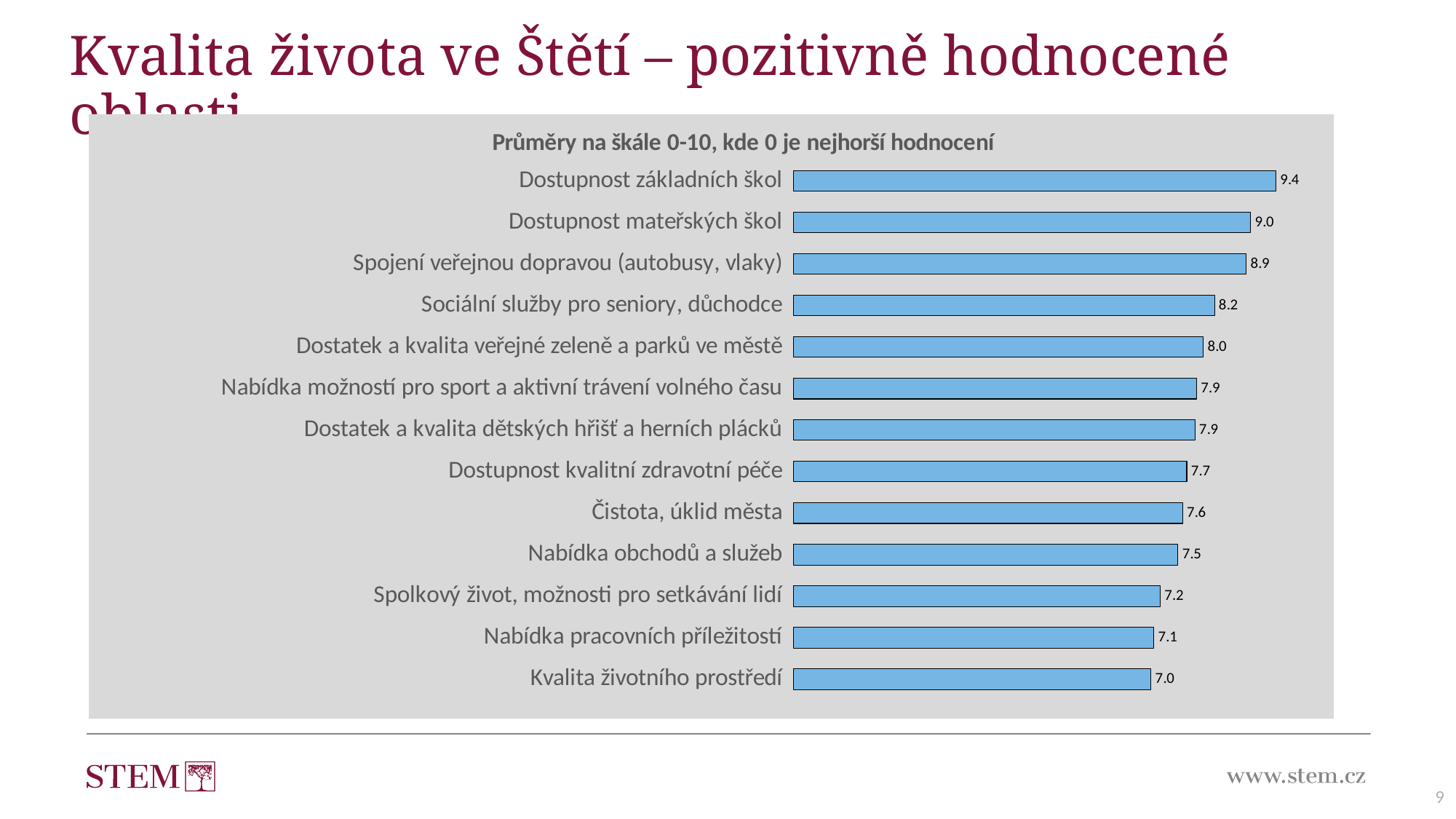
How many categories are shown in the chart? 13 What is the difference between the values for Sociální služby pro seniory, důchodce and Nabídka obchodů a služeb? 0.7 What kind of chart is shown on the slide? bar chart What colour are the bars in the chart? blue What is the value for Nabídka pracovních příležitostí? 7.1 Which category has the lowest value? Kvalita životního prostředí What is the difference between the values for Dostupnost základních škol and Kvalita životního prostředí? 2.4 Which category has the highest value? Dostupnost základních škol What is the title of the chart? Průměry na škále 0-10, kde 0 je nejhorší hodnocení Which is larger: the value for Dostupnost mateřských škol or the value for Dostupnost kvalitní zdravotní péče? Dostupnost mateřských škol What is the value for Čistota, úklid města? 7.6 What is the value for Dostupnost základních škol? 9.4